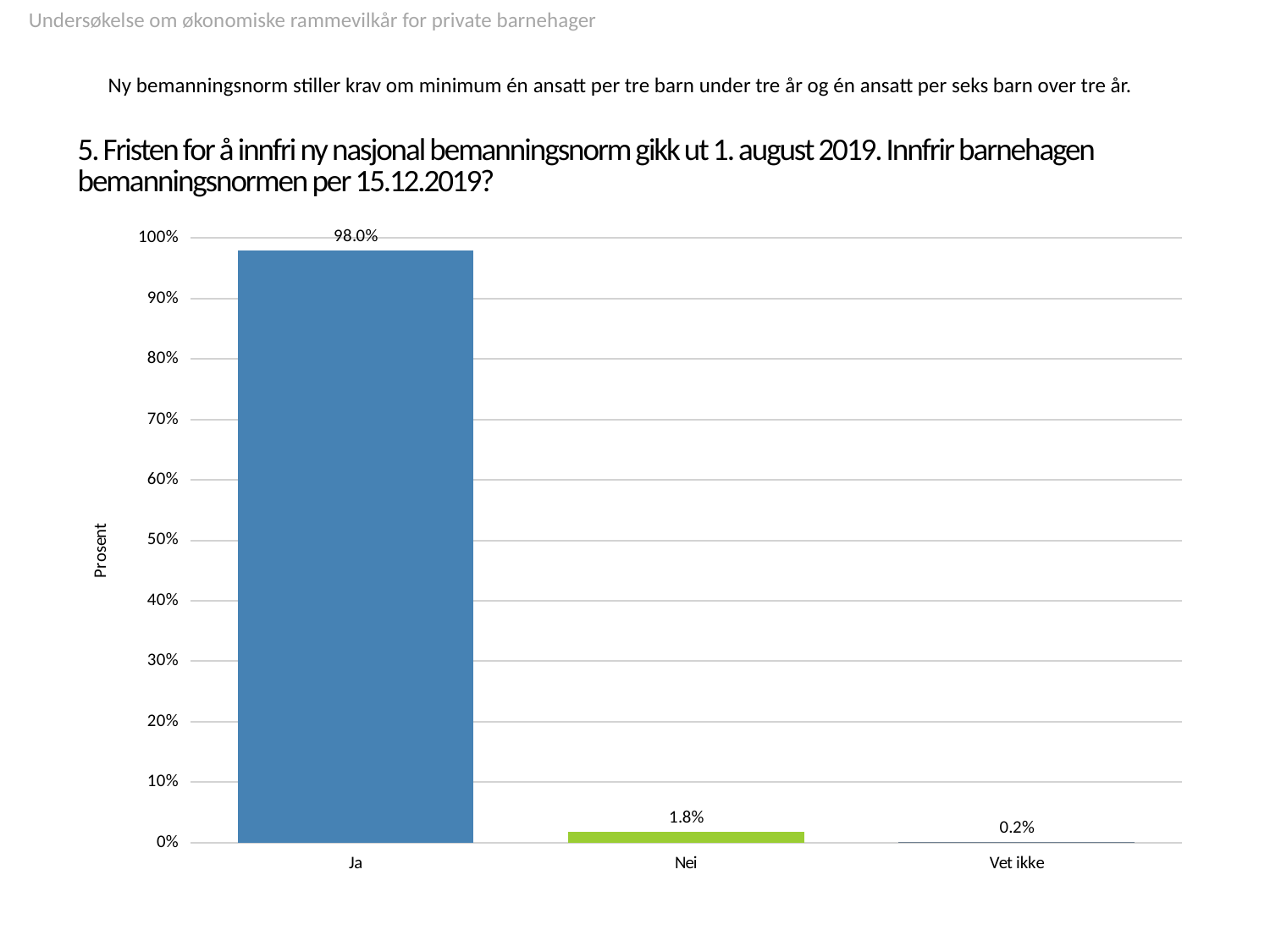
Which category has the lowest value? Vet ikke Which category has the highest value? Ja Is the value for Ja greater or less than 90%? greater What kind of chart is shown on the slide? bar chart How many categories are shown on the x axis? 3 What is the value for Ja? 98.0% What is the difference between the values for Nei and Vet ikke? 1.6% What is the value for Nei? 1.8% What is the value for Vet ikke? 0.2% What is the label of the y axis? Prosent What is the difference between the values for Ja and Nei? 96.2% Which is larger, the value for Nei or the value for Vet ikke? Nei